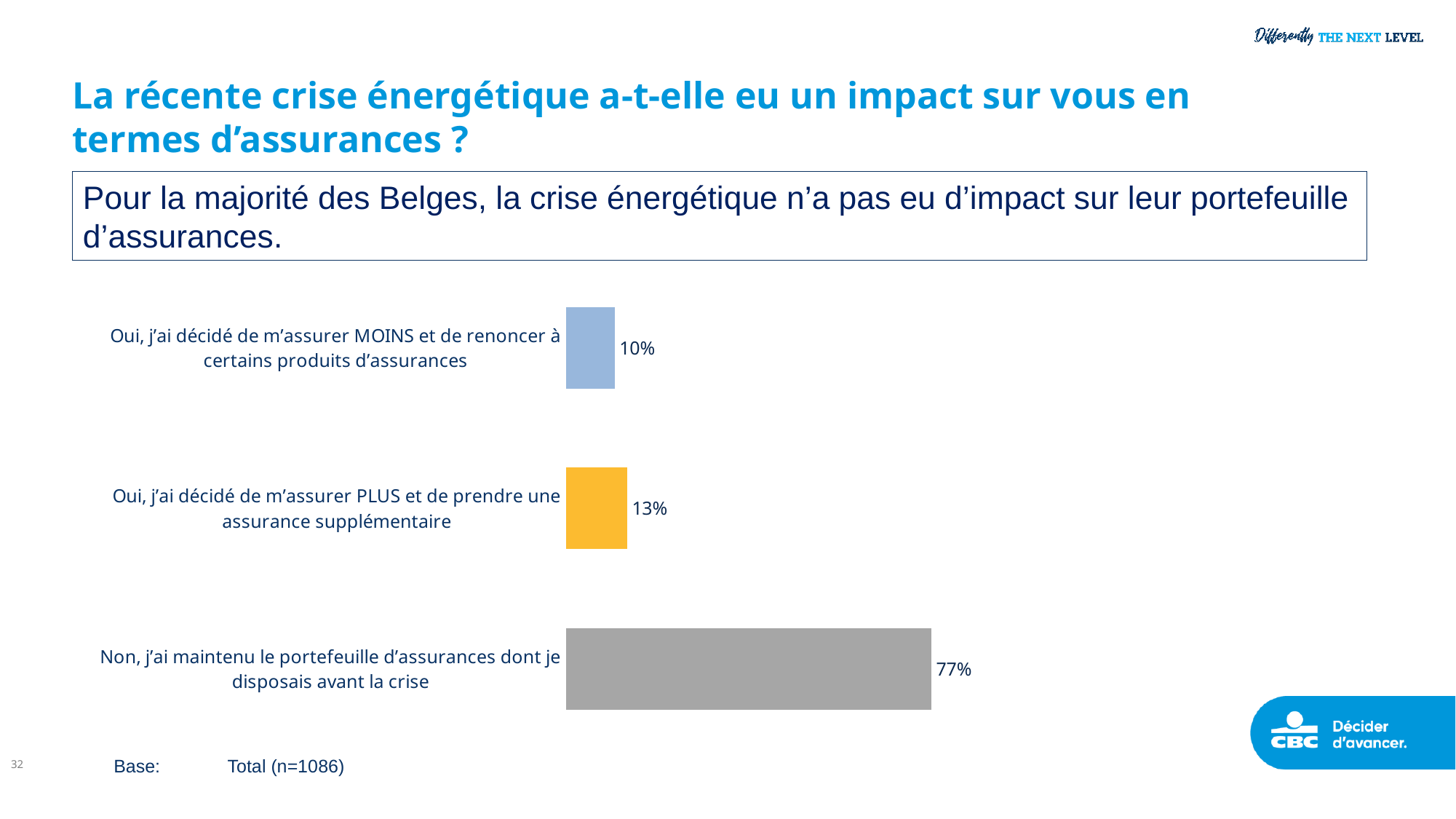
What kind of chart is shown on the slide? Bar chart What percentage of respondents said they decided to insure themselves LESS and give up certain insurance products? 10% What is the difference in percentage points between those who decided to insure themselves MORE (13%) and those who decided to insure themselves LESS (10%)? 3 percentage points Which response category has the lowest value? Oui, j'ai décidé de m'assurer MOINS et de renoncer à certains produits d'assurances What percentage of respondents said they decided to insure themselves MORE and take out additional insurance? 13% Which response category has the highest value? Non, j'ai maintenu le portefeuille d'assurances dont je disposais avant la crise What is the difference in percentage points between those who maintained their portfolio (77%) and those who decided to insure themselves MORE (13%)? 64 percentage points How many response categories are shown in the chart? 3 What percentage of respondents said they maintained the insurance portfolio they had before the crisis? 77% What is the base (sample size) indicated for the chart? Total (n=1086) Which is larger: the share who decided to insure themselves MORE or the share who decided to insure themselves LESS? Insure themselves MORE (13%) What colour is the bar for the category 'Oui, j'ai décidé de m'assurer PLUS et de prendre une assurance supplémentaire'? Orange/yellow